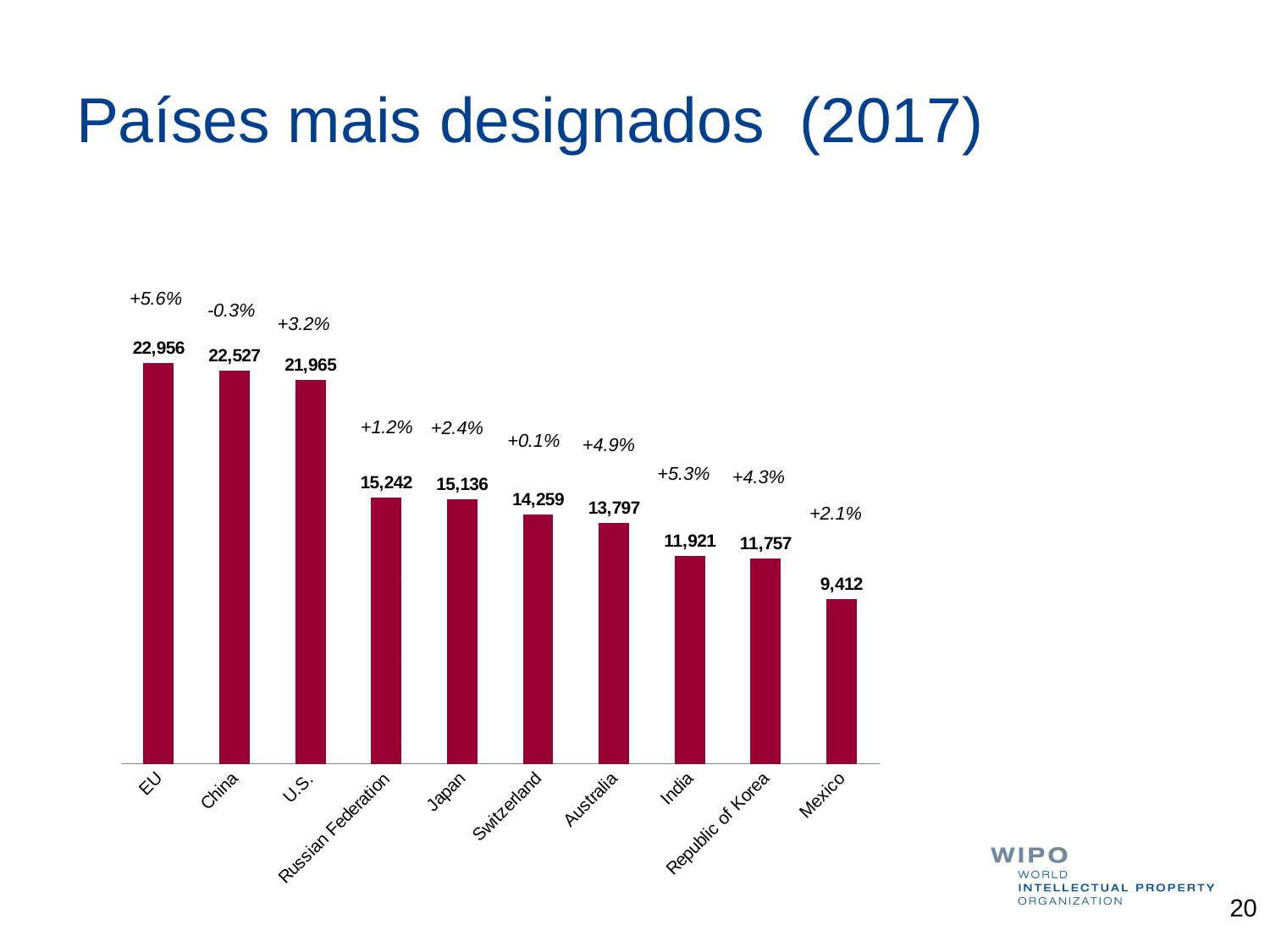
What is the value for Mexico? 9,412 Which is larger, the value for Australia or the value for India? Australia What kind of chart is shown on the slide? Bar chart What is the difference between the values for EU and U.S.? 991 What is the percentage change shown above the bar for India? +5.3% What is the difference between the values for Russian Federation and Japan? 106 Which category has the lowest value? Mexico Do the values rise or fall from left to right along the x axis? Fall How many categories are shown on the x axis? 10 Which category has the highest value? EU What is the value for China? 22,527 What is the value for Switzerland? 14,259